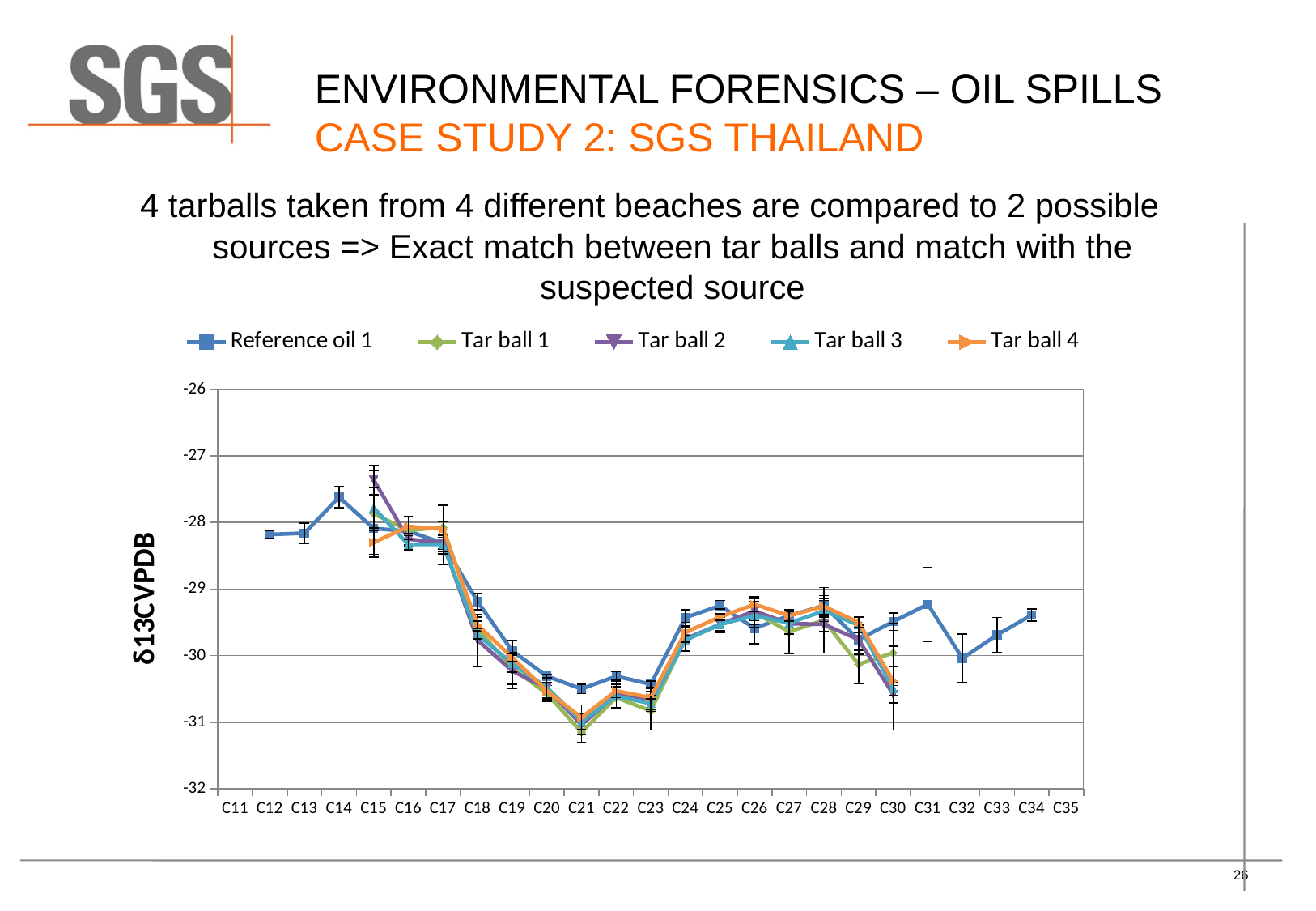
Is the value for Tar ball 2 at C15 greater or less than -28? greater Is the value for Reference oil 1 at C14 greater or less than -28? greater What kind of chart is shown on the slide? line chart Is the value for Reference oil 1 at C31 greater or less than -30? greater Which series reaches the highest value on the chart? Tar ball 2 How many categories are labelled on the x axis? 25 How many series does the legend list? 5 Which series is shown in orange in the legend? Tar ball 4 Do the values for Reference oil 1 rise or fall from C17 to C21? fall What is the title of the y axis? δ13CVPDB